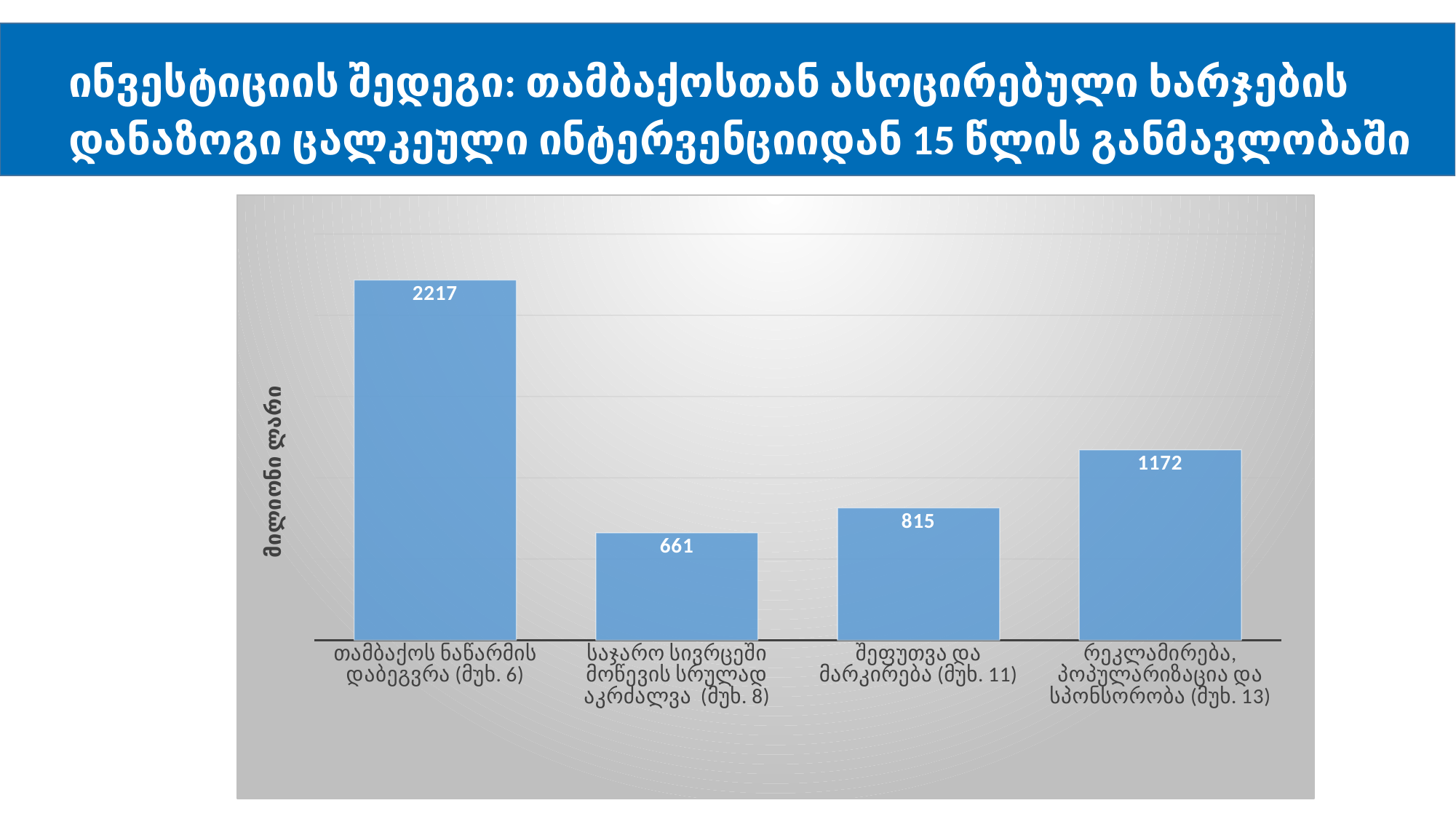
Which category has the lowest value? საჯარო სივრცეში მოწევის სრულად აკრძალვა (მუხ. 8) Which is larger: the value for შეფუთვა და მარკირება (მუხ. 11) or the value for რეკლამირება, პოპულარიზაცია და სპონსორობა (მუხ. 13)? რეკლამირება, პოპულარიზაცია და სპონსორობა (მუხ. 13) What is the value for საჯარო სივრცეში მოწევის სრულად აკრძალვა (მუხ. 8)? 661 What is the value for შეფუთვა და მარკირება (მუხ. 11)? 815 What is the value for თამბაქოს ნაწარმის დაბეგვრა (მუხ. 6)? 2217 How many categories are shown in the chart? 4 What is the difference between the values for შეფუთვა და მარკირება (მუხ. 11) and საჯარო სივრცეში მოწევის სრულად აკრძალვა (მუხ. 8)? 154 What is the label on the vertical axis of the chart? მილიონი ლარი What kind of chart is shown on the slide? Bar chart Which category has the highest value? თამბაქოს ნაწარმის დაბეგვრა (მუხ. 6) What is the difference between the values for თამბაქოს ნაწარმის დაბეგვრა (მუხ. 6) and რეკლამირება, პოპულარიზაცია და სპონსორობა (მუხ. 13)? 1045 What is the value for რეკლამირება, პოპულარიზაცია და სპონსორობა (მუხ. 13)? 1172